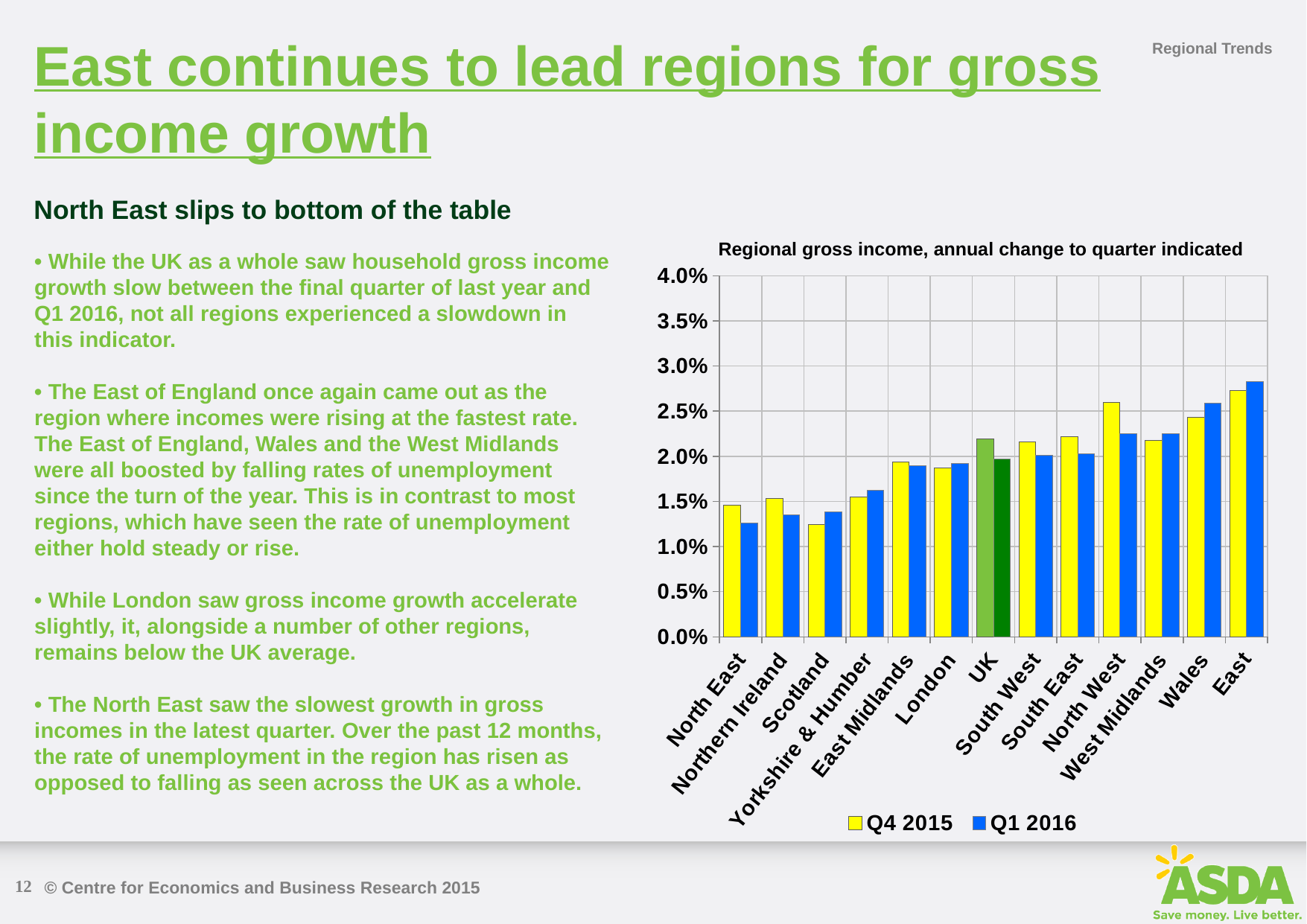
How many series does the legend list? 2 For North West, which is larger: the Q4 2015 value or the Q1 2016 value? Q4 2015 Is the Q1 2016 value for North East greater or less than 1.5%? less Which region has the lowest Q1 2016 value? North East Which region has the lowest Q4 2015 value? Scotland What kind of chart is shown on the slide? bar chart Is the Q1 2016 value for East greater or less than 2.5%? greater For Wales, which is larger: the Q4 2015 value or the Q1 2016 value? Q1 2016 Is the Q4 2015 value for North West greater or less than 2.5%? greater Which region has the highest Q1 2016 value? East How many regions (categories) are shown on the x axis of the chart? 13 What is the title of the chart? Regional gross income, annual change to quarter indicated